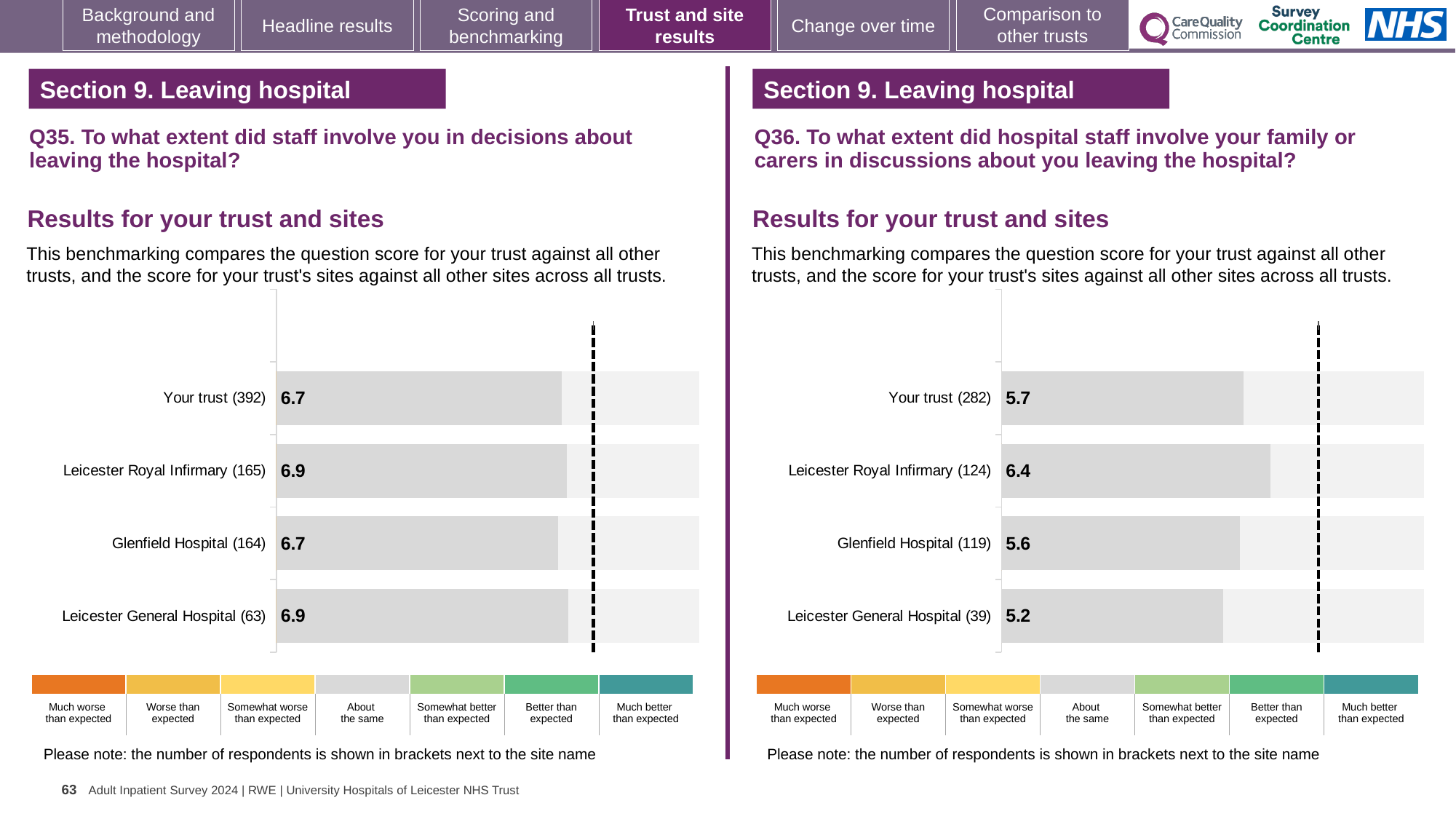
In the Q36 chart on the right, what is the difference between the scores for Leicester Royal Infirmary and Leicester General Hospital? 1.2 In the Q35 chart on the left, what is the score for Leicester General Hospital? 6.9 In the Q36 chart on the right, which site or trust has the highest score? Leicester Royal Infirmary How many bars are shown in the Q35 chart on the left? 4 In the Q35 chart on the left, how many respondents are shown in brackets for Leicester Royal Infirmary? 165 In the Q36 chart on the right, what is the score for Leicester Royal Infirmary? 6.4 In the Q36 chart on the right, what is the score for Glenfield Hospital? 5.6 In the Q35 chart on the left, which has the higher score, Leicester Royal Infirmary or Glenfield Hospital? Leicester Royal Infirmary In the Q36 chart on the right, which site or trust has the lowest score? Leicester General Hospital In the Q35 chart on the left, what is the score for Your trust? 6.7 What type of chart is used for the Q36 results on the right? Bar chart In the Q36 chart on the right, which has the higher score, Your trust or Leicester General Hospital? Your trust